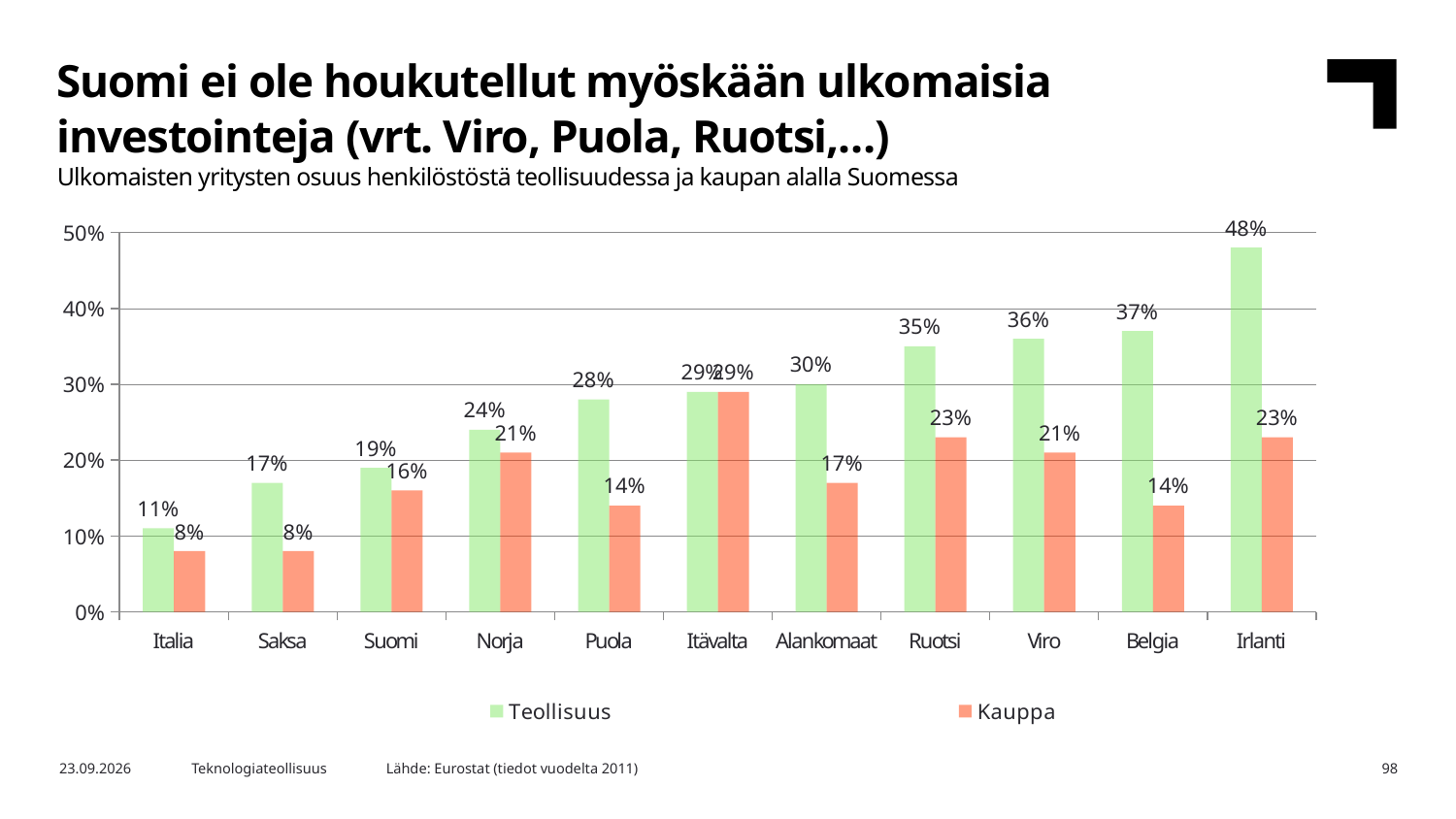
What kind of chart is shown on the slide? Bar chart What is the Teollisuus value for Viro? 36% What is the difference between the Teollisuus and Kauppa values for Puola? 14% Which country has the lowest Teollisuus value? Italia Which is larger for Norja, the Teollisuus value or the Kauppa value? Teollisuus What is the Teollisuus value for Suomi? 19% Is the Teollisuus value for Belgia greater or less than 30%? greater How many series does the legend list? 2 Which series is shown in green? Teollisuus Which country has the highest Teollisuus value? Irlanti What is the Kauppa value for Ruotsi? 23% How many countries are shown on the x axis? 11